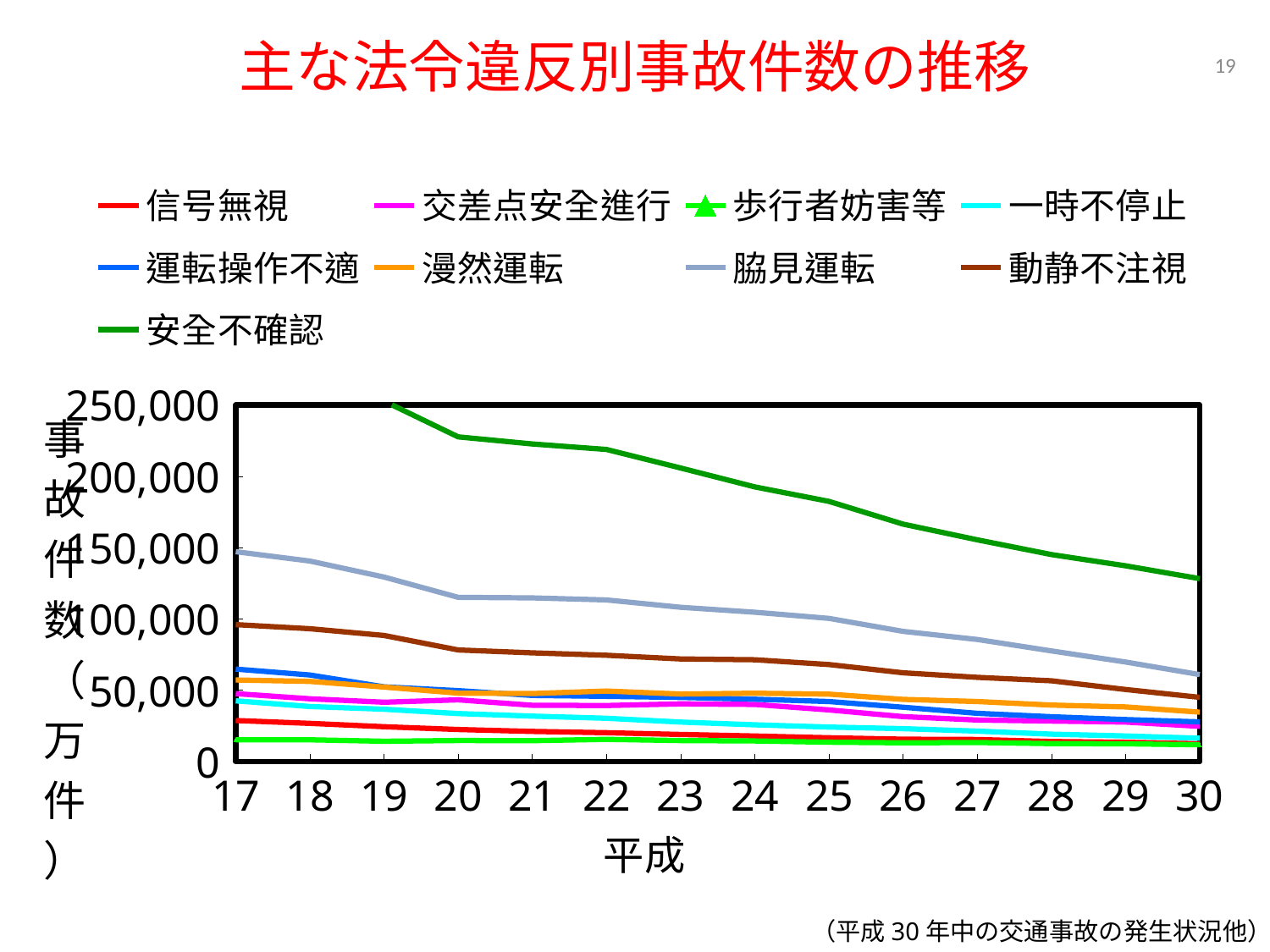
Which series has the highest values throughout the chart? 安全不確認 How many series does the legend list? 9 Is the value for 脇見運転 in 平成30 greater or less than 50,000? greater Which series has the lowest values throughout the chart? 歩行者妨害等 In 平成17, which is larger: 脇見運転 or 動静不注視? 脇見運転 What is the title of the chart? 主な法令違反別事故件数の推移 How many years (points) are shown along the x axis? 14 Does the 安全不確認 line rise or fall from 平成20 to 平成30? fall Is the value for 安全不確認 in 平成30 greater or less than 100,000? greater What is the label of the x axis? 平成 Is the value for 安全不確認 in 平成20 greater or less than 200,000? greater What kind of chart is shown on the slide? line chart